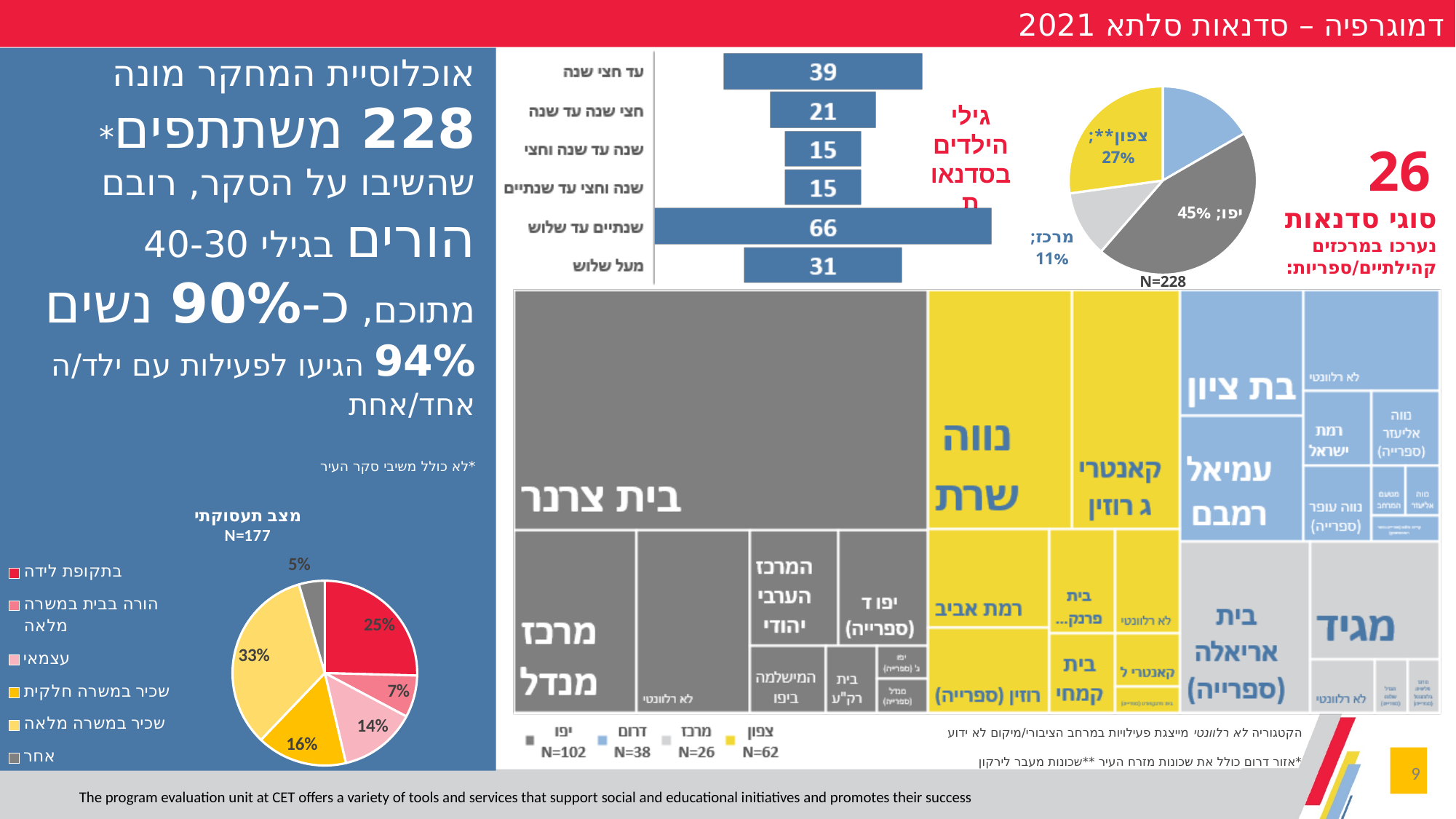
In the bar chart of children's ages, what is the value for עד חצי שנה? 39 In the bar chart of children's ages (גילי הילדים בסדנאות), what is the value for שנתיים עד שלוש? 66 In the employment status pie chart (מצב תעסוקתי), what share does שכיר במשרה מלאה have? 33% In the employment status pie chart (מצב תעסוקתי), which category has the largest slice? שכיר במשרה מלאה What kind of chart is used to show the children's ages (גילי הילדים בסדנאות)? bar chart In the pie chart of regions at the top right (N=228), what share does יפו have? 45% In the pie chart of regions at the top right, what share does מרכז have? 11% In the bar chart of children's ages, which is larger: the value for עד חצי שנה or the value for מעל שלוש? עד חצי שנה In the bar chart of children's ages, which age category has the highest value? שנתיים עד שלוש In the bar chart of children's ages, what is the difference between the values for שנתיים עד שלוש and עד חצי שנה? 27 How many age categories are shown in the bar chart of children's ages? 6 How many categories does the legend of the employment status pie chart (מצב תעסוקתי) list? 6